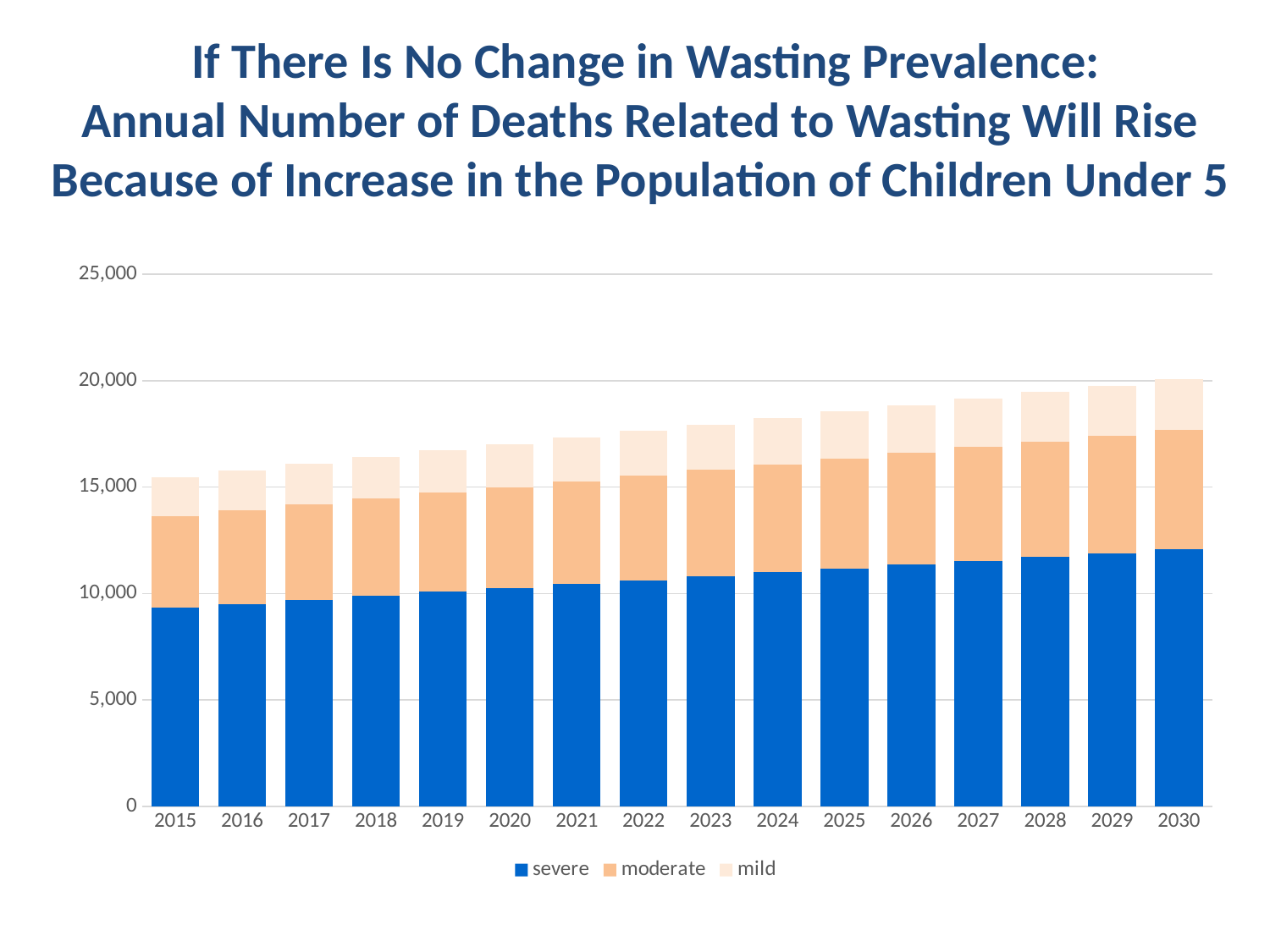
Which series is shown in dark blue? severe How many years are shown along the x axis? 16 Which is larger: severe wasting deaths in 2030 or severe wasting deaths in 2015? 2030 How many series does the legend list? 3 Do the total annual deaths rise or fall from 2015 to 2030? rise Is the total number of deaths in 2015 greater or less than 20,000? less Which year has the highest total number of deaths? 2030 Is the value for severe wasting deaths in 2015 greater or less than 10,000? less Which series forms the bottom segment of each stacked bar? severe Is the value for severe wasting deaths in 2025 greater or less than 10,000? greater What kind of chart is shown on the slide? stacked bar chart Which year has the lowest total number of deaths? 2015